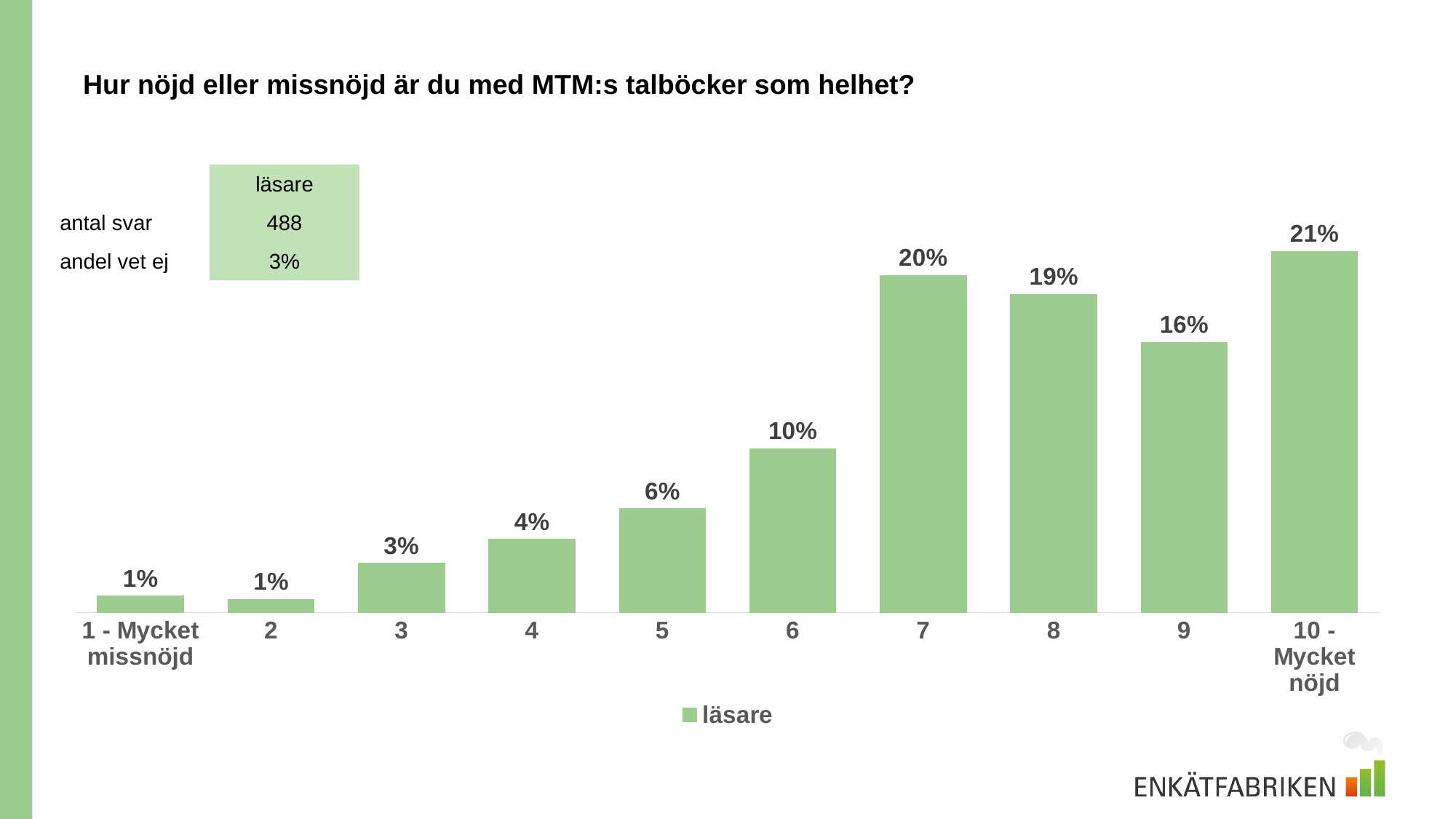
How many categories are shown on the x axis? 10 What is the value for category 7? 20% Do the values generally rise or fall from category 1 to category 7? rise What is the value for category 5? 6% What is the difference between the values for category 8 and category 6? 9% How many series does the legend list? 1 Which category has the highest value? 10 - Mycket nöjd What is the chart's title? Hur nöjd eller missnöjd är du med MTM:s talböcker som helhet? What is the name of the series in the legend? läsare What is the value for category 9? 16% What kind of chart is shown? bar chart Which is larger, the value for category 7 or the value for category 8? 7